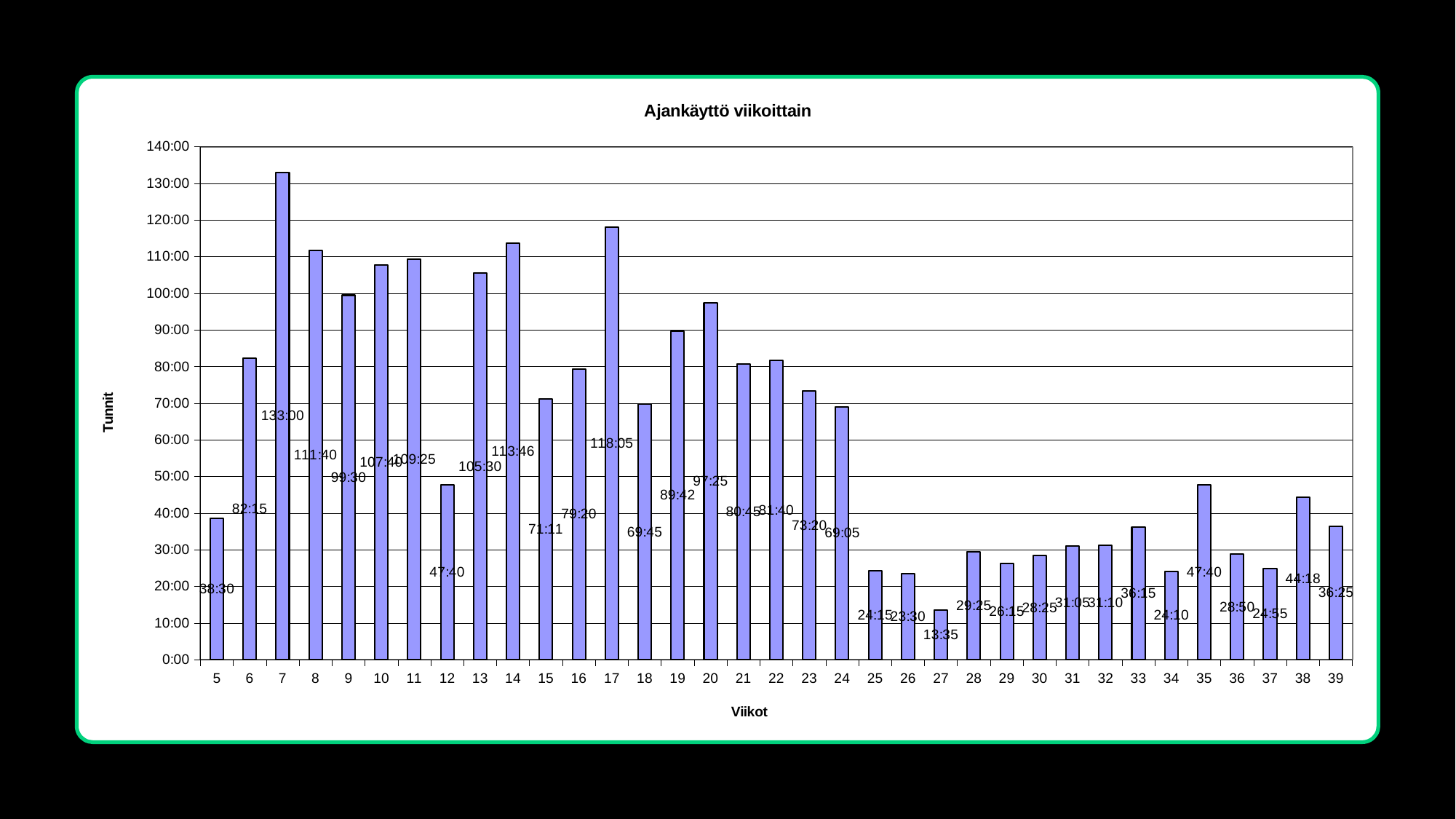
Which is larger, the value for week 13 or week 14? week 14 What is the value for week 27? 13:35 Do the values rise or fall from week 24 to week 27? fall How many weeks are shown on the x axis? 35 What is the title of the chart? Ajankäyttö viikoittain Is the value for week 20 greater or less than 90:00? greater Which week has the lowest value? 27 Which week has the highest value? 7 What kind of chart is this? bar chart What is the difference between the values for week 7 and week 17? 14:55 What is the value for week 7? 133:00 What is the value for week 17? 118:05